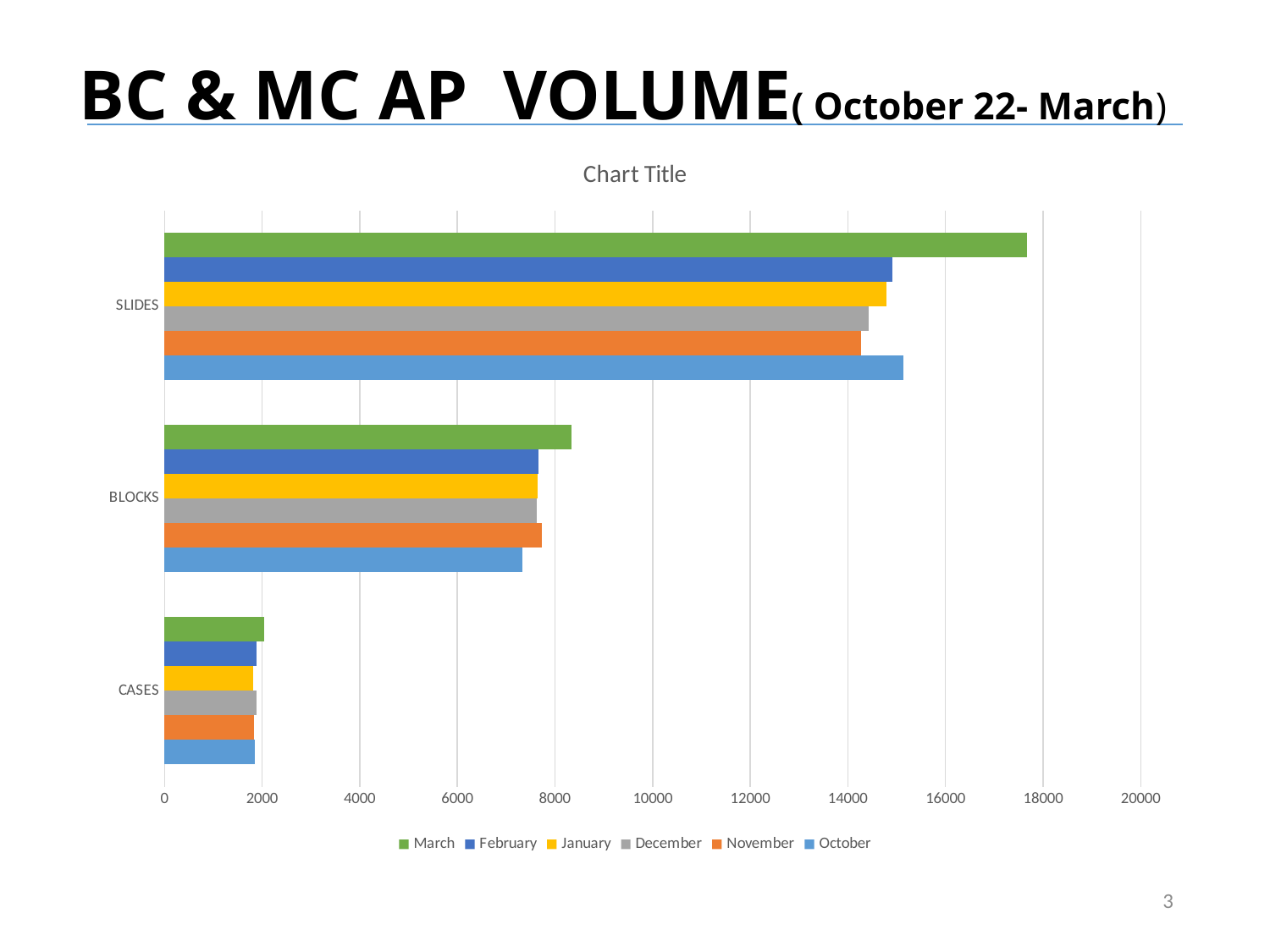
Is the March value for CASES greater or less than 4000? less Is the March value for SLIDES greater or less than 16000? greater Which is larger for SLIDES: the March value or the October value? March For SLIDES, which month has the highest value? March What is the title shown above the chart? Chart Title What kind of chart is shown on the slide? bar chart How many series does the chart legend list? 6 Which category has the lowest values across all months? CASES Which category has the highest March value? SLIDES How many categories are shown on the vertical axis of the chart? 3 Is the October value for SLIDES greater or less than 14000? greater